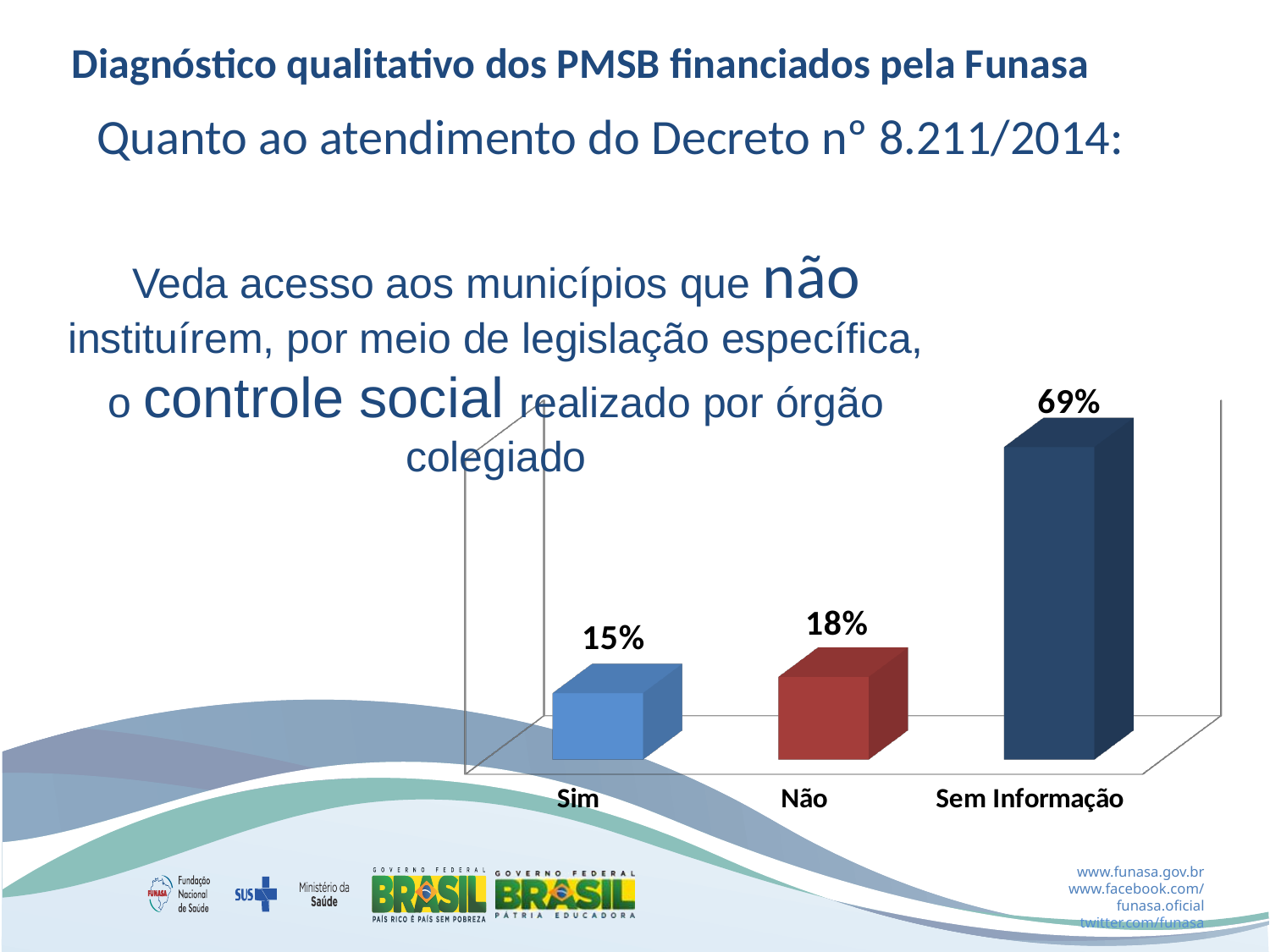
How many categories are shown in the chart? 3 Which category has the lowest value? Sim Which category has the highest value? Sem Informação What kind of chart is shown on the slide? bar chart What is the value for Sim? 15% What is the difference between the values for Sem Informação and Não? 51% What is the value for Sem Informação? 69% What is the difference between the values for Não and Sim? 3% Do the values rise or fall from left to right across the categories? rise Which is larger, the value for Sim or the value for Não? Não What colour is the bar for Não? red What is the value for Não? 18%